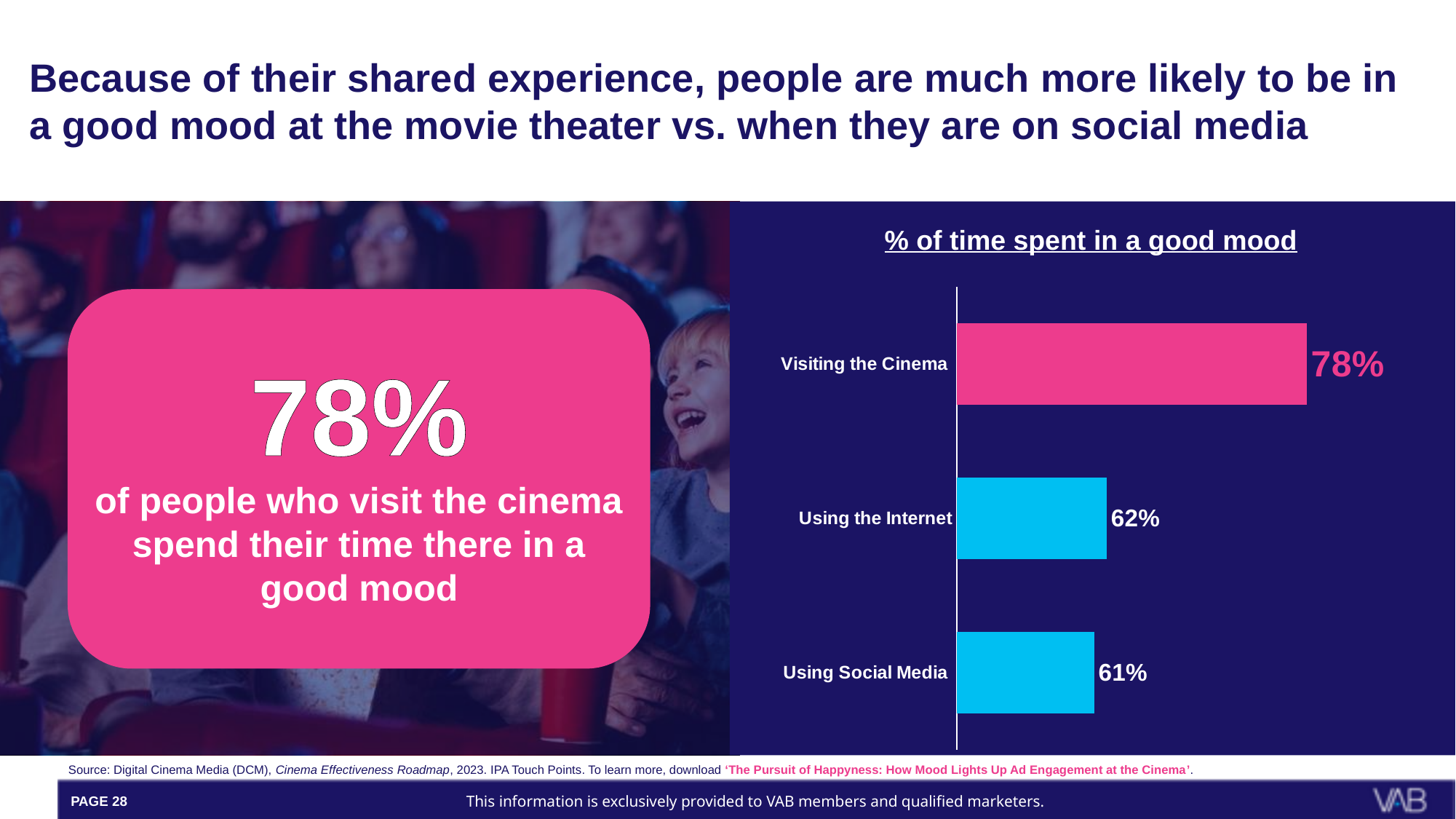
What is the title of the chart? % of time spent in a good mood What is the value for Using the Internet? 62% What kind of chart is shown on the slide? Bar chart What is the difference between the values for Using the Internet and Using Social Media? 1% Which bar in the chart is coloured pink rather than blue? Visiting the Cinema What is the value for Using Social Media? 61% What is the value for Visiting the Cinema? 78% Which category has the highest % of time spent in a good mood? Visiting the Cinema How many categories are shown in the chart? 3 Which is larger, the value for Visiting the Cinema or the value for Using the Internet? Visiting the Cinema What is the difference between the values for Visiting the Cinema and Using Social Media? 17% Which category has the lowest % of time spent in a good mood? Using Social Media